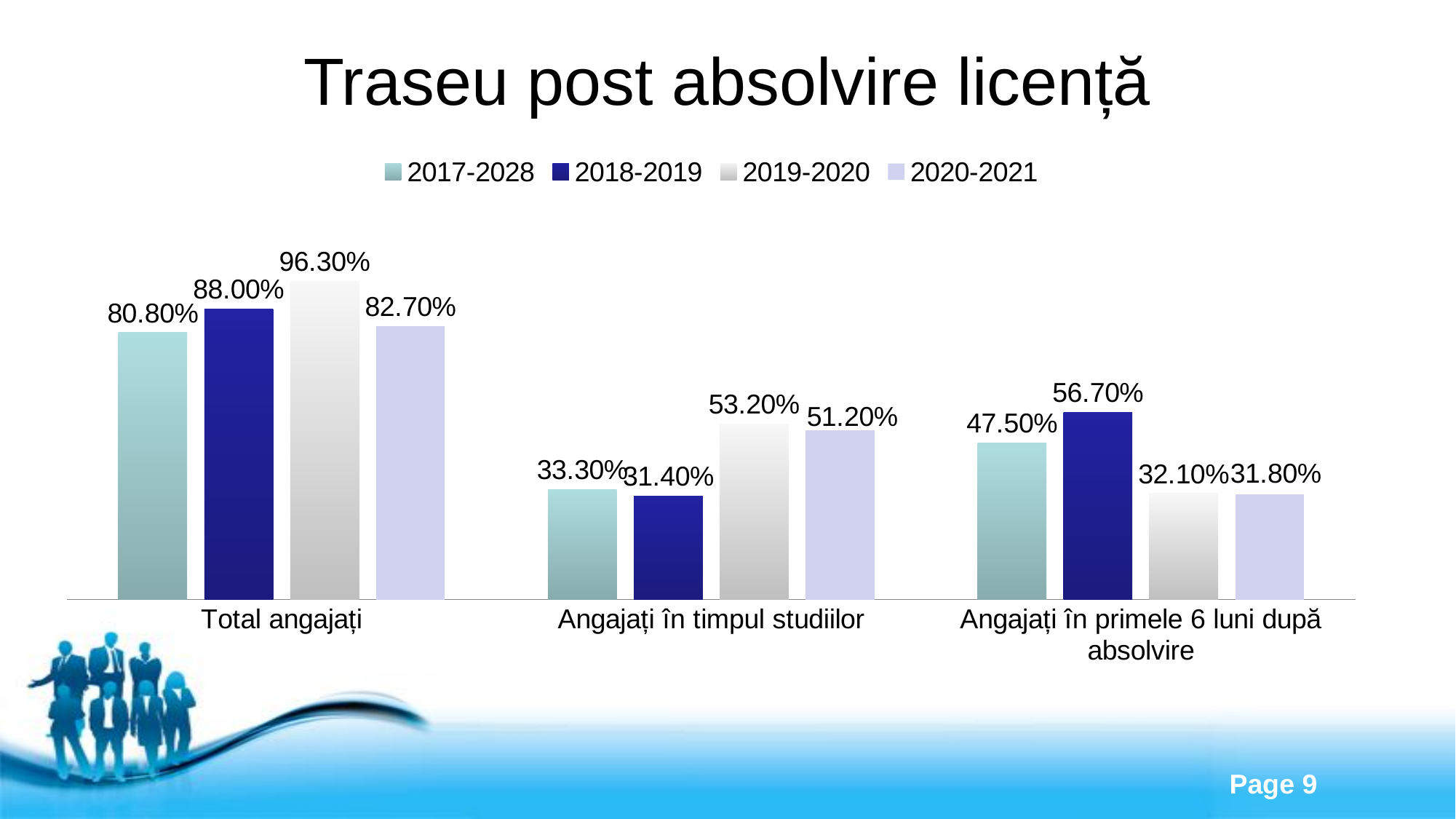
What is the title of the slide containing the chart? Traseu post absolvire licență What is the value for 2018-2019 in the "Angajați în primele 6 luni după absolvire" category? 56.70% Which series has the lowest value in the "Angajați în timpul studiilor" category? 2018-2019 How many categories are shown on the x axis of the chart? 3 In the "Angajați în primele 6 luni după absolvire" category, which is larger: the 2017-2028 value or the 2019-2020 value? 2017-2028 What is the value for 2019-2020 in the "Total angajați" category? 96.30% Which series has the highest value in the "Total angajați" category? 2019-2020 What kind of chart is shown on the slide? Bar chart What is the difference between the 2018-2019 and 2017-2028 values in the "Total angajați" category? 7.20% What is the difference between the 2019-2020 and 2020-2021 values in the "Angajați în timpul studiilor" category? 2.00% What is the value for 2020-2021 in the "Angajați în timpul studiilor" category? 51.20% How many series does the legend list? 4